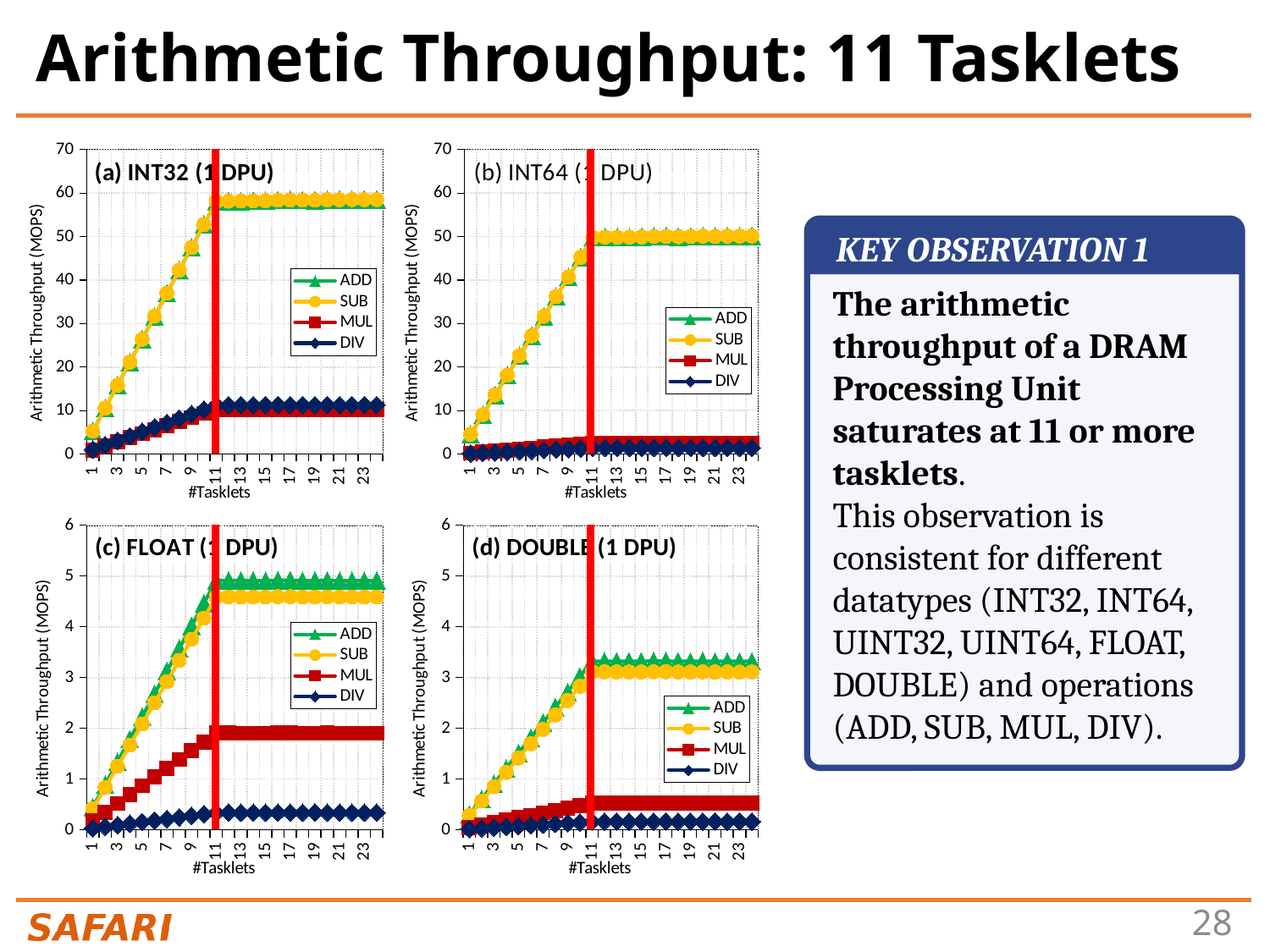
In the (c) FLOAT (1 DPU) chart, is the ADD value at 23 tasklets greater or less than 4? greater In the (d) DOUBLE (1 DPU) chart, is the DIV value at 23 tasklets greater or less than 1? less What kind of chart is the top-left chart, (a) INT32 (1 DPU)? line chart In the (a) INT32 (1 DPU) chart, does the ADD series rise or fall as the number of tasklets increases from 1 to 11? rise In the (a) INT32 (1 DPU) chart, is the DIV value at 23 tasklets greater or less than 20? less How many series does the legend of the (a) INT32 (1 DPU) chart list? 4 In the (c) FLOAT (1 DPU) chart, which series has the lowest throughput at 23 tasklets? DIV In the (d) DOUBLE (1 DPU) chart, which is larger at 23 tasklets, MUL or DIV? MUL